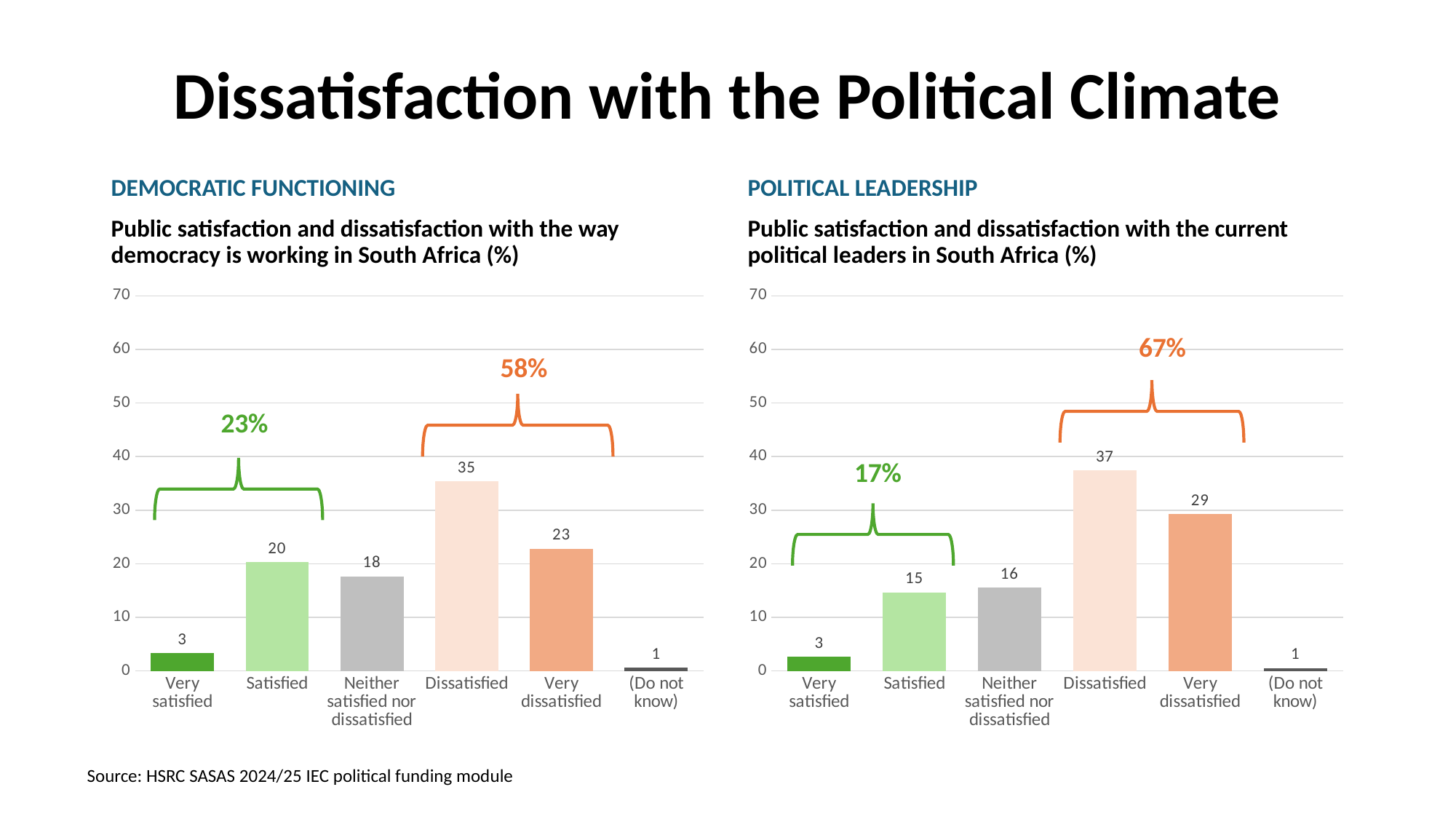
In the Democratic Functioning chart, what is the difference between Dissatisfied and Very dissatisfied? 12 In the Democratic Functioning chart, what is the value for Dissatisfied? 35 In the Political Leadership chart, what combined percentage is shown by the orange bracket over Dissatisfied and Very dissatisfied? 67% In the Political Leadership chart, which category has the lowest value? (Do not know) In the Democratic Functioning chart, which category has the highest value? Dissatisfied What kind of chart is the Democratic Functioning chart? Bar chart In the Democratic Functioning chart, is the value for Satisfied greater or less than 10? greater How many categories are shown on the x axis of the Political Leadership chart? 6 In the Democratic Functioning chart, what combined percentage is shown by the green bracket over Very satisfied and Satisfied? 23% In the Political Leadership chart, what is the value for Very dissatisfied? 29 In the Political Leadership chart, what is the value for Satisfied? 15 In the Political Leadership chart, which is larger: Satisfied or Neither satisfied nor dissatisfied? Neither satisfied nor dissatisfied